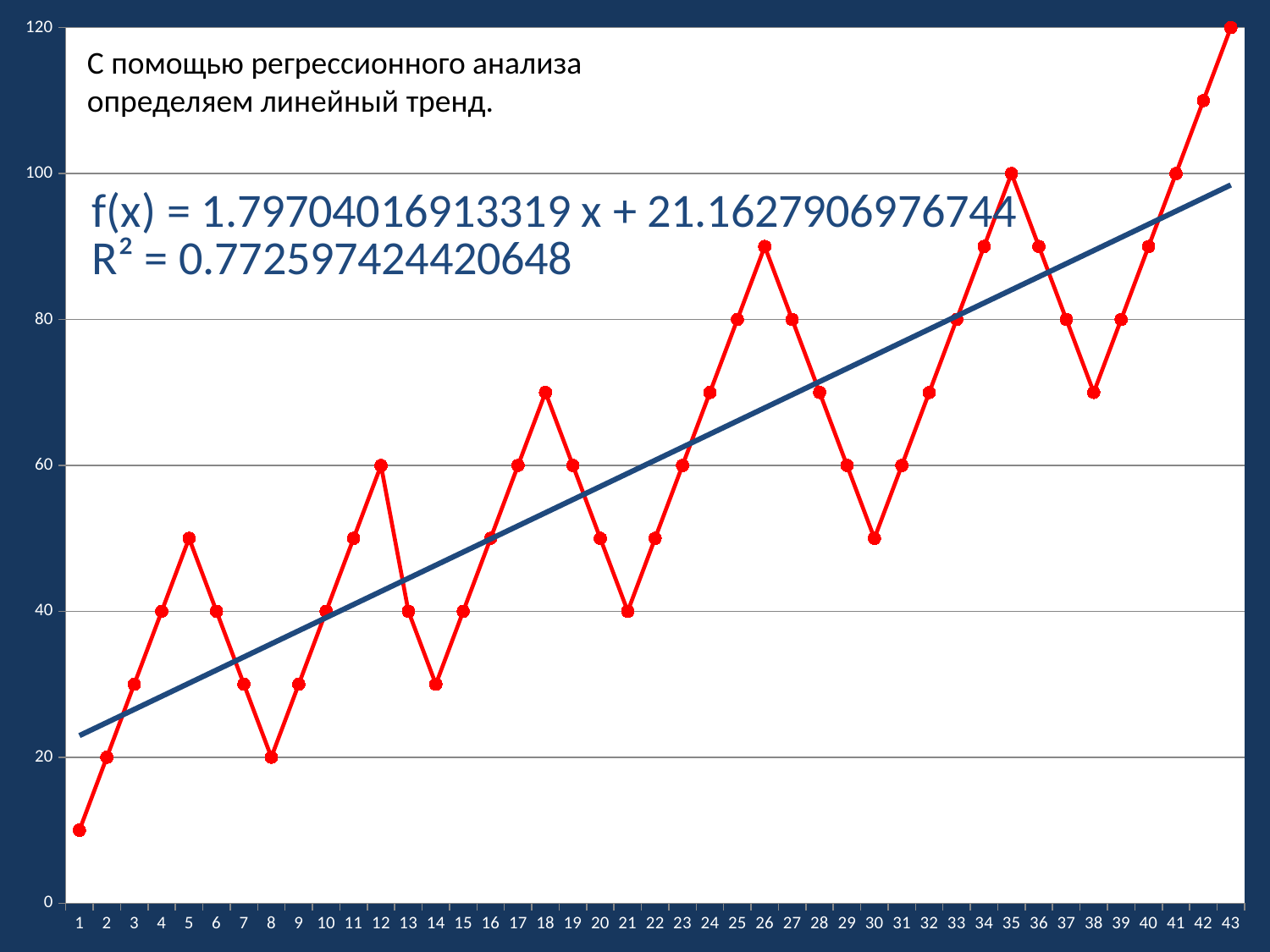
What kind of chart is shown on the slide? line chart Which x-axis point has the highest value? 43 Do the values generally rise or fall from point 1 to point 43? rise What is the value at point 43? 120 Which x-axis point has the lowest value? 1 Which is larger, the value at point 18 or the value at point 21? point 18 What is the value at point 8? 20 What is the value at point 35? 100 How many data points are plotted along the x axis? 43 What R² value is shown for the linear trend line? 0.772597424420648 What is the value at point 12? 60 Is the value at point 26 greater or less than 80? greater